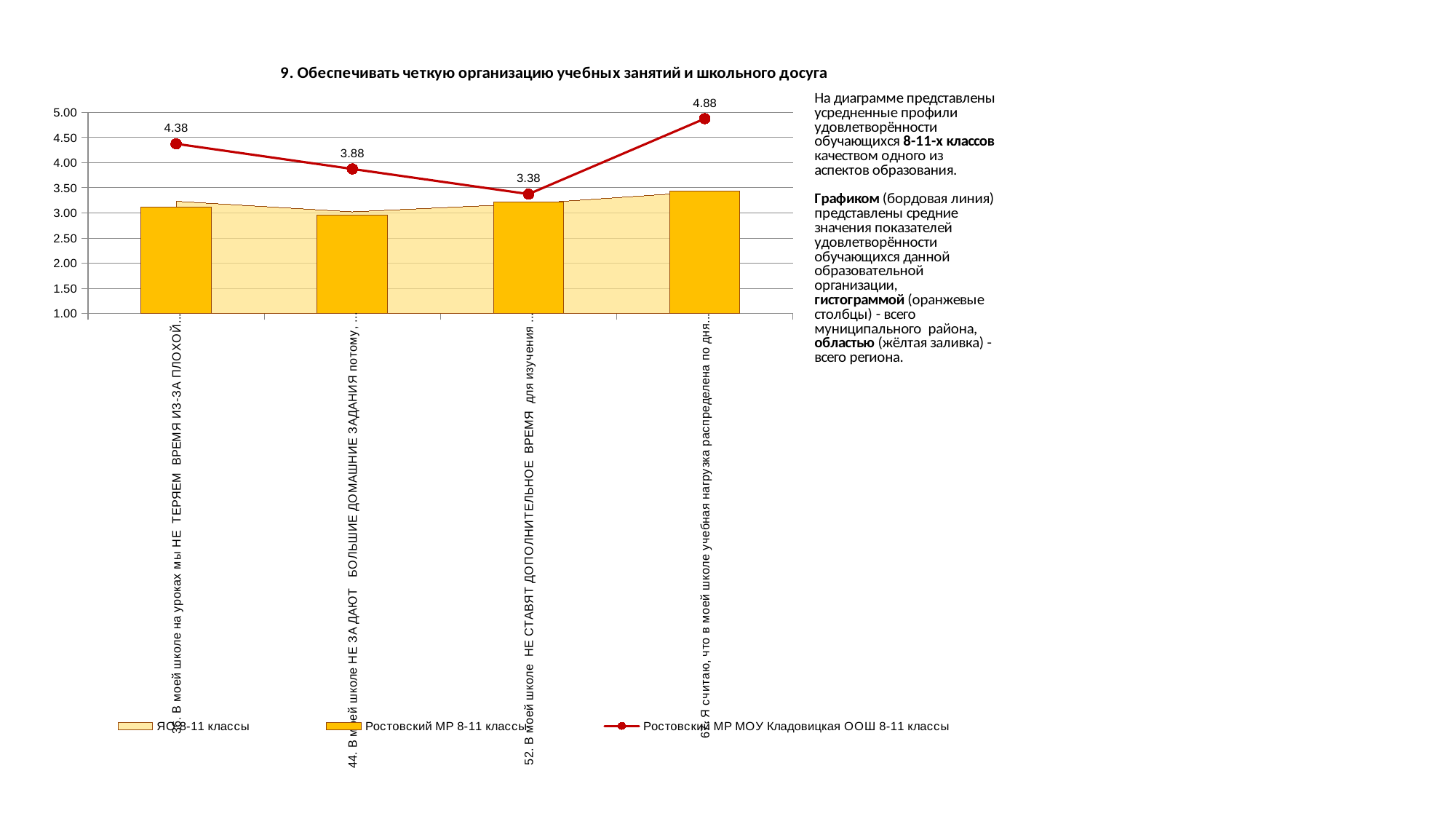
What is the difference between the highest and lowest values on the Ростовский МР МОУ Кладовицкая ООШ 8-11 классы line? 1.50 How many series does the legend list? 3 How many categories are shown on the x axis? 4 Which category has the lowest value on the Ростовский МР МОУ Кладовицкая ООШ 8-11 классы line? 52. В моей школе НЕ СТАВЯТ ДОПОЛНИТЕЛЬНОЕ ВРЕМЯ (3.38) What is the value of the Ростовский МР МОУ Кладовицкая ООШ 8-11 классы line for category 52 (В моей школе НЕ СТАВЯТ ДОПОЛНИТЕЛЬНОЕ ВРЕМЯ)? 3.38 Does the Ростовский МР МОУ Кладовицкая ООШ 8-11 классы line rise or fall from category 52 to the last category? rise On the Ростовский МР МОУ Кладовицкая ООШ 8-11 классы line, which is larger: the value for category 44 or for category 52? Category 44 What is the value of the Ростовский МР МОУ Кладовицкая ООШ 8-11 классы line for category 44 (В моей школе НЕ ЗАДАЮТ БОЛЬШИЕ ДОМАШНИЕ ЗАДАНИЯ)? 3.88 By how much does the Ростовский МР МОУ Кладовицкая ООШ 8-11 классы line value for the first category (4.38) exceed the value for category 44 (3.88)? 0.50 Which category has the highest value on the Ростовский МР МОУ Кладовицкая ООШ 8-11 классы line? Я считаю, что в моей школе учебная нагрузка распределена по дням (4.88) Is the Ростовский МР 8-11 классы bar for category 52 greater or less than 3.50? less Is the Ростовский МР 8-11 классы bar for the last category (учебная нагрузка распределена по дням) greater or less than 3.00? greater